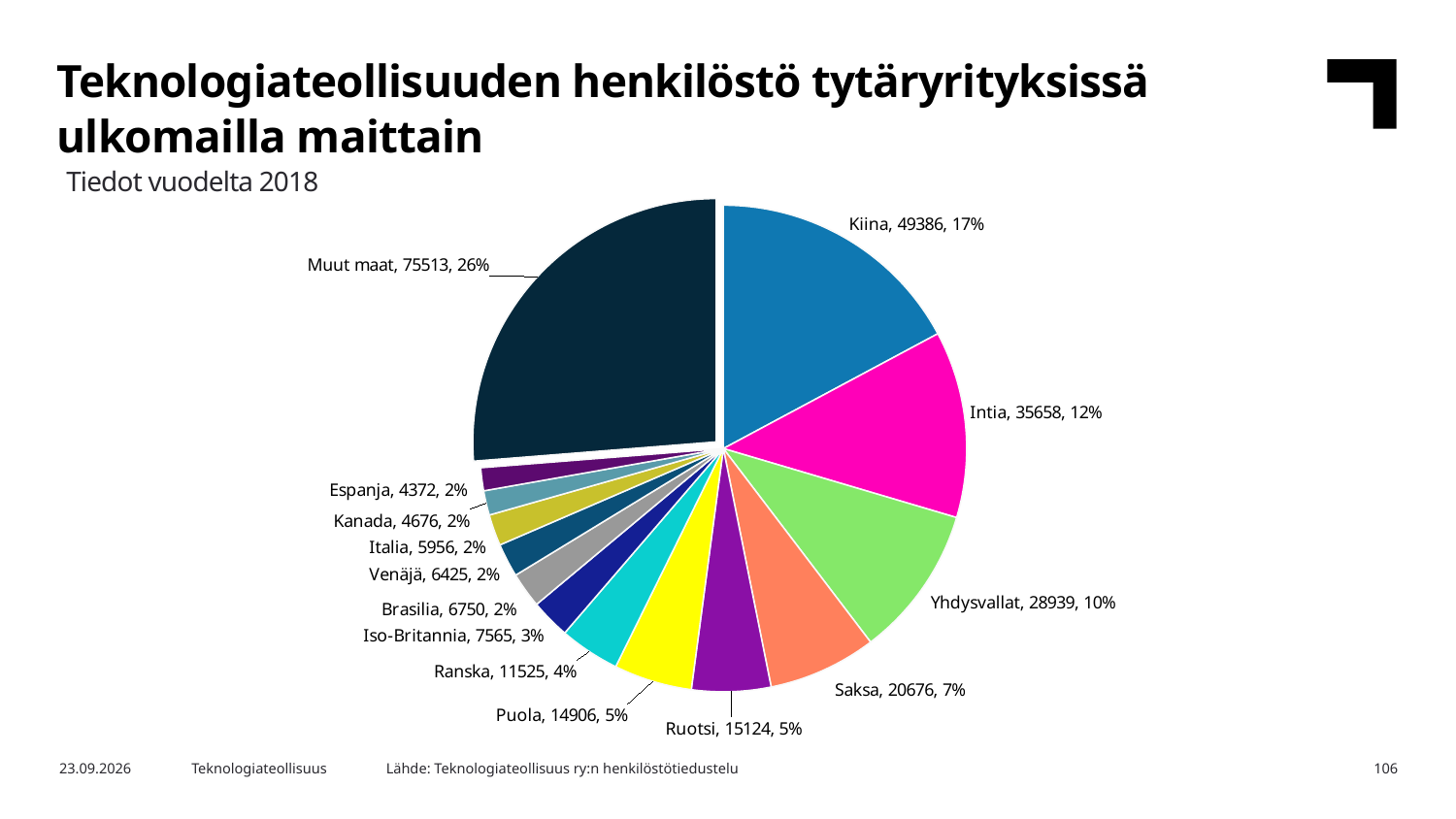
What share of the pie does Muut maat represent? 26% What share of the pie does Intia represent? 12% Which is larger, the value for Saksa or the value for Ruotsi? Saksa What is the value for Kiina? 49386 How many slices does the pie chart have? 14 What is the value for Iso-Britannia? 7565 What is the difference between the values for Kiina and Intia? 13728 What kind of chart is shown on the slide? Pie chart Which slice is the largest in the pie chart? Muut maat What is the title of the chart on the slide? Teknologiateollisuuden henkilöstö tytäryrityksissä ulkomailla maittain Which slice is the smallest in the pie chart? Espanja What is the value for Yhdysvallat? 28939